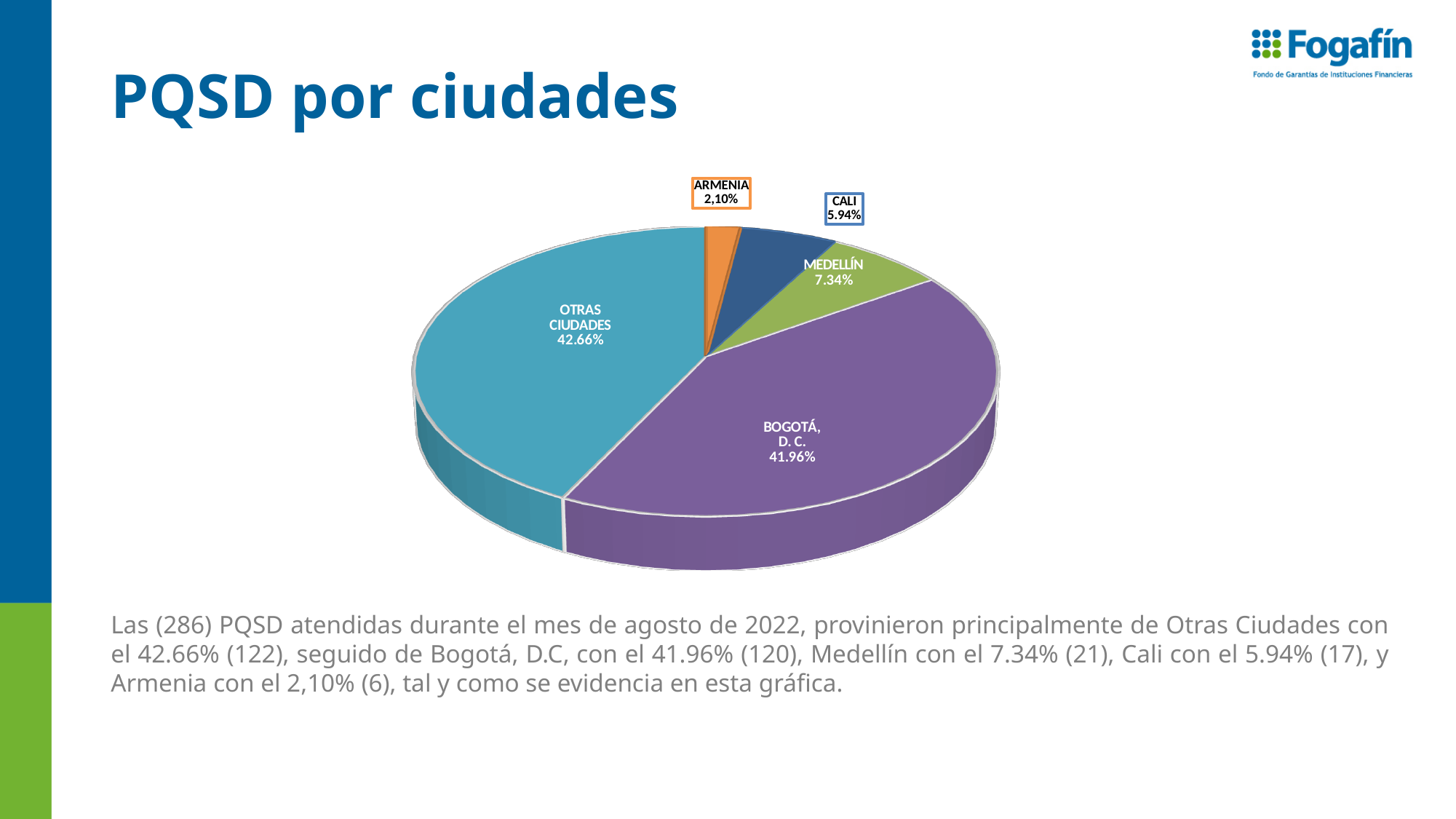
Which is larger, the slice for Medellín or the slice for Cali? Medellín What type of chart is shown on the slide? Pie chart What is the value shown for Armenia? 2,10% What is the value shown for Bogotá, D. C.? 41.96% What is the difference in percentage points between Medellín and Cali? 1.40 Which city category has the smallest slice of the pie? Armenia What is the value shown for Cali? 5.94% What is the value shown for Medellín? 7.34% What share of the pie does Otras Ciudades hold? 42.66% What is the title of the slide containing the chart? PQSD por ciudades Which category has the largest slice of the pie? Otras Ciudades How many slices does the pie chart have? 5